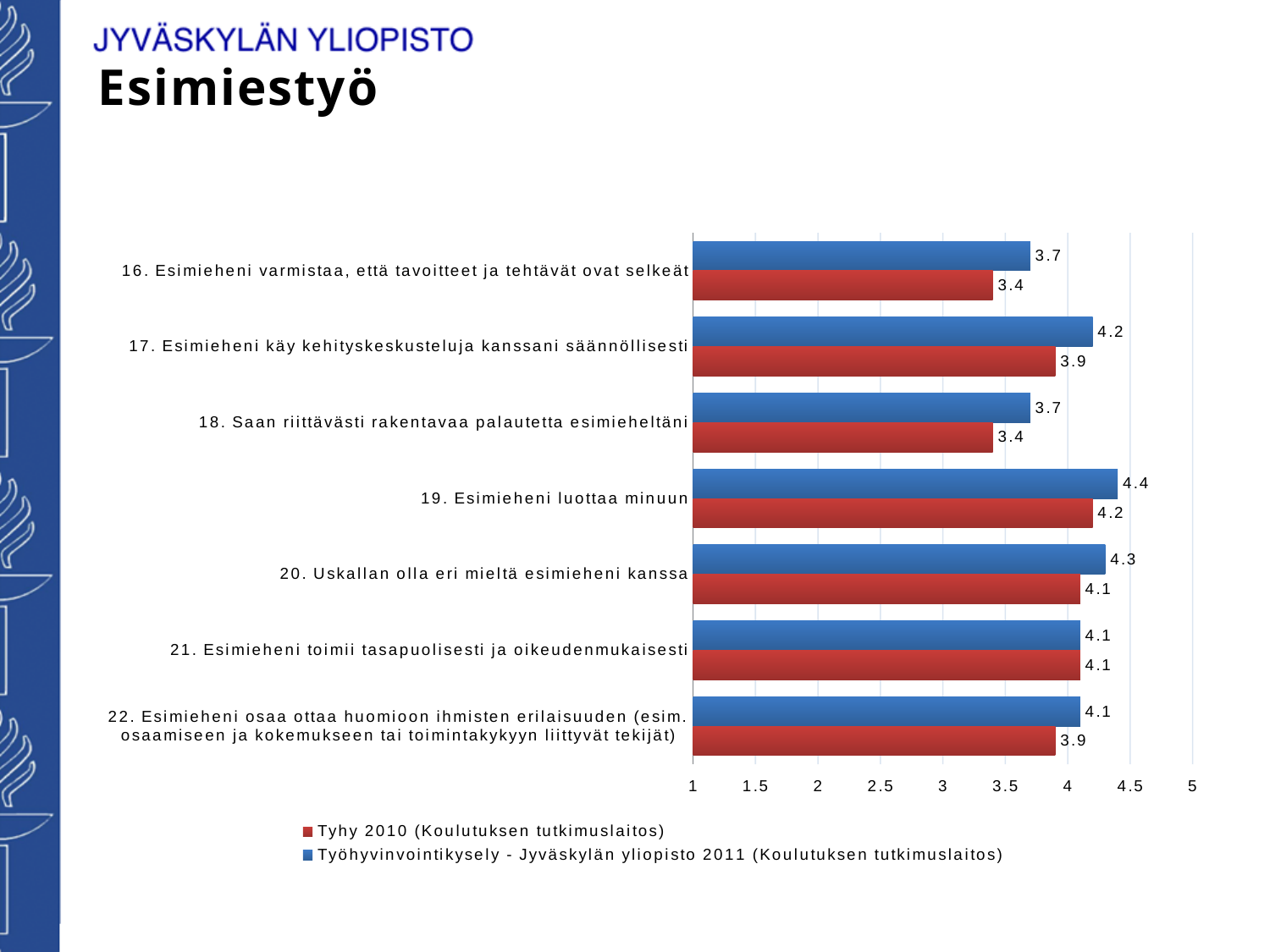
Which statement has the highest Työhyvinvointikysely 2011 value? 19. Esimieheni luottaa minuun What is the difference between the 2011 and 2010 values for "18. Saan riittävästi rakentavaa palautetta esimieheltäni"? 0.3 What kind of chart is shown on the slide? bar chart Which colour represents the Tyhy 2010 series in the chart? red How many categories (statements) are plotted in the chart? 7 What is the Työhyvinvointikysely 2011 value for "17. Esimieheni käy kehityskeskusteluja kanssani säännöllisesti"? 4.2 How many series does the legend list? 2 For "20. Uskallan olla eri mieltä esimieheni kanssa", which series has the larger value, Tyhy 2010 or Työhyvinvointikysely 2011? Työhyvinvointikysely 2011 Which statement has the lowest Tyhy 2010 value, "16. Esimieheni varmistaa, että tavoitteet ja tehtävät ovat selkeät" or "20. Uskallan olla eri mieltä esimieheni kanssa"? 16. Esimieheni varmistaa, että tavoitteet ja tehtävät ovat selkeät Is the Tyhy 2010 value for "16. Esimieheni varmistaa, että tavoitteet ja tehtävät ovat selkeät" greater or less than 3.5? less What is the Tyhy 2010 value for "22. Esimieheni osaa ottaa huomioon ihmisten erilaisuuden"? 3.9 What is the Tyhy 2010 value for "19. Esimieheni luottaa minuun"? 4.2